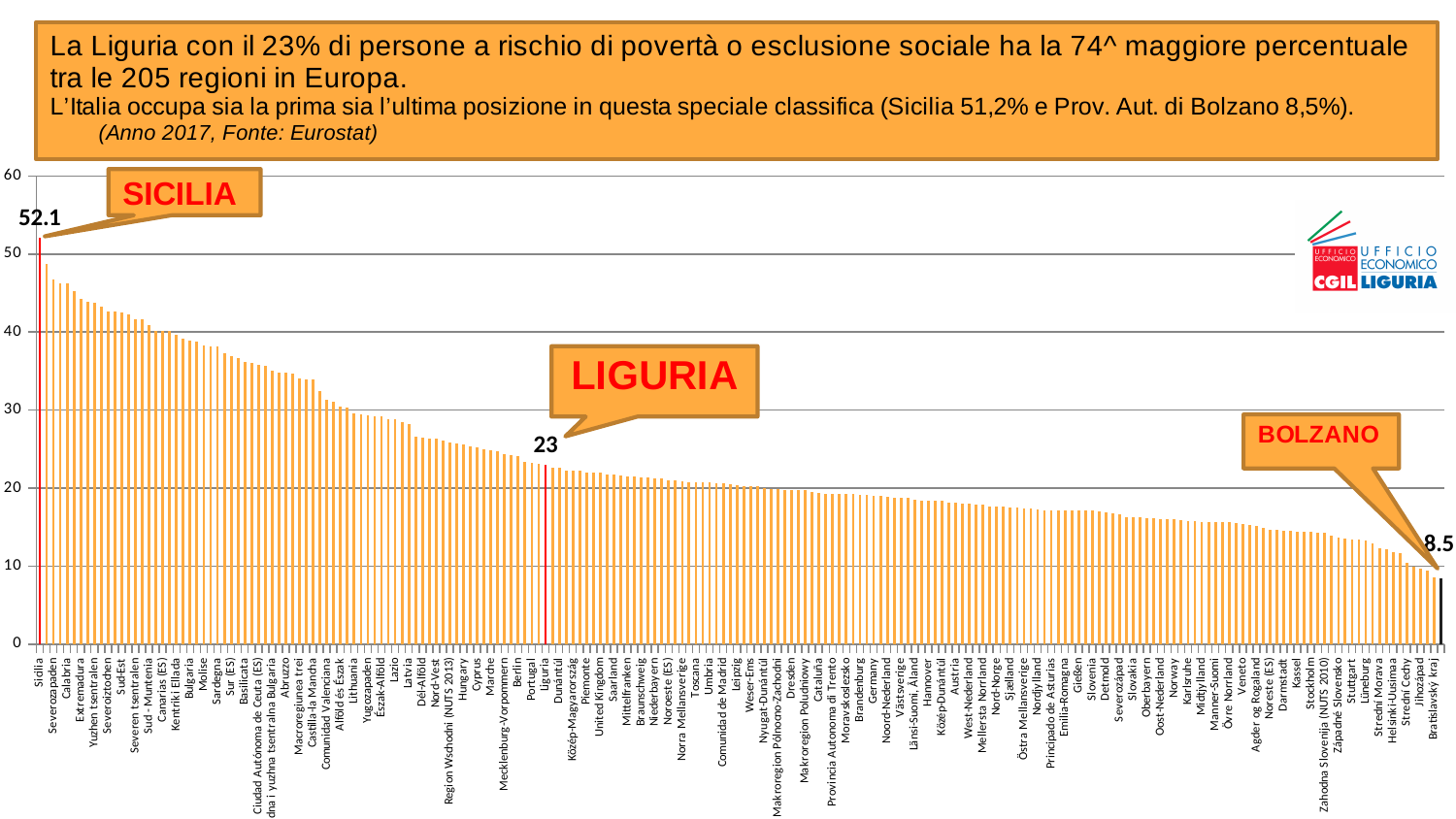
Is the value for Calabria greater or less than 40? greater Which region has the highest bar in the chart? Sicilia What is the difference between the printed values for Sicilia (52.1) and Liguria (23)? 29.1 What is the difference between the printed values for Liguria (23) and the bar marked BOLZANO (8.5)? 14.5 Is the value for Toscana greater or less than 30? less What value is printed above the bar for Liguria? 23 Do the bar values rise or fall from left to right along the x axis? fall What kind of chart is shown on the slide? bar chart What is the highest value shown on the vertical axis? 60 What value is printed above the bar for Sicilia? 52.1 What value is printed next to the bar marked by the BOLZANO callout? 8.5 Which has the larger value, Sicilia or Liguria? Sicilia